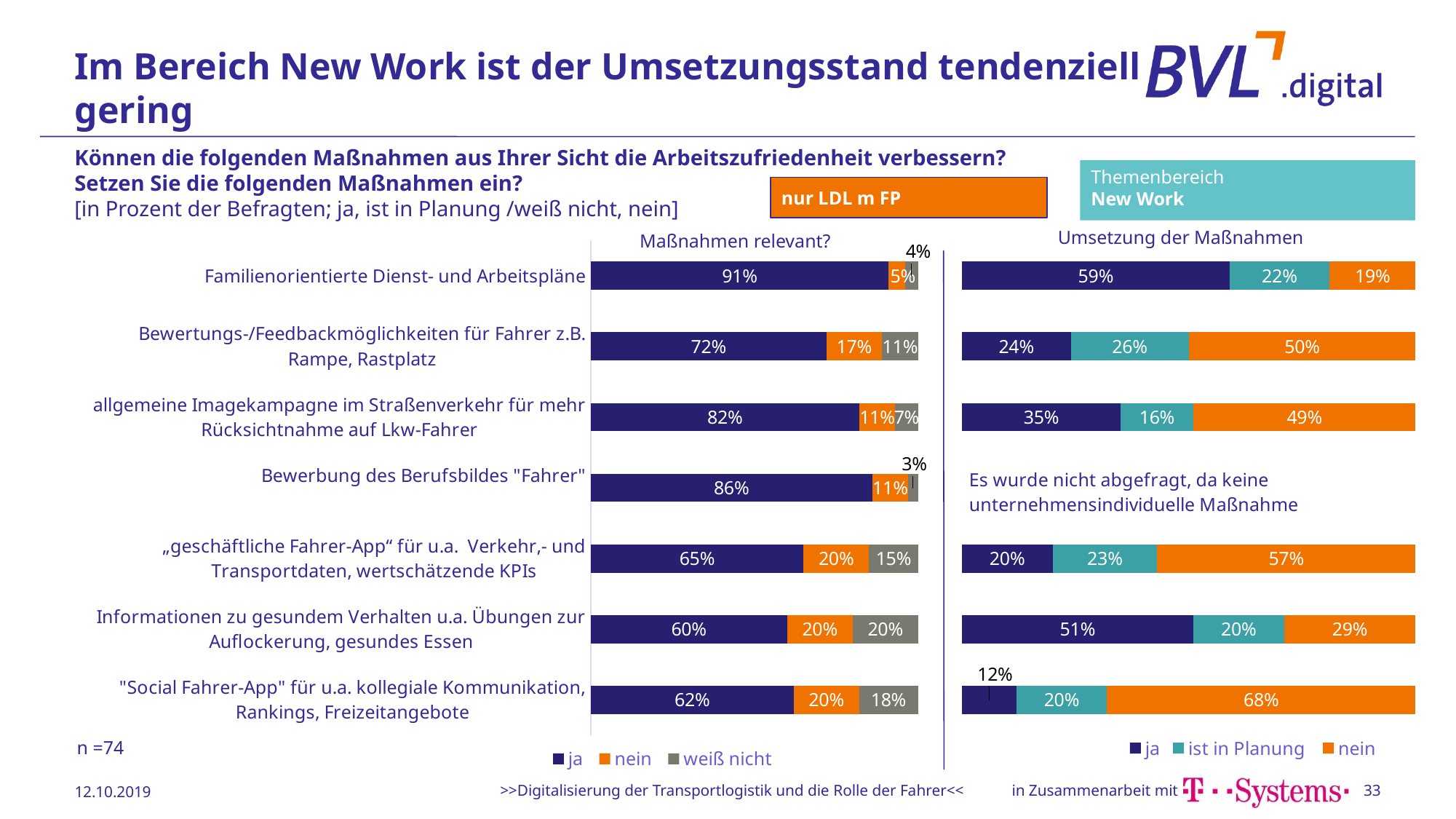
What kind of chart is the 'Maßnahmen relevant?' chart? Stacked bar chart In the 'Maßnahmen relevant?' chart, what is the difference between the 'ja' values for 'Bewerbung des Berufsbildes "Fahrer"' and 'Informationen zu gesundem Verhalten u.a. Übungen zur Auflockerung, gesundes Essen'? 26% In the 'Umsetzung der Maßnahmen' chart, what is the 'nein' value for '"Social Fahrer-App" für u.a. kollegiale Kommunikation, Rankings, Freizeitangebote'? 68% How many categories (bars) are shown in the 'Maßnahmen relevant?' chart? 7 In the 'Umsetzung der Maßnahmen' chart, which is larger: the 'ja' value for 'Familienorientierte Dienst- und Arbeitspläne' or the 'ja' value for 'allgemeine Imagekampagne im Straßenverkehr für mehr Rücksichtnahme auf Lkw-Fahrer'? Familienorientierte Dienst- und Arbeitspläne In the 'Umsetzung der Maßnahmen' chart, which category has the lowest 'ja' value? "Social Fahrer-App" für u.a. kollegiale Kommunikation, Rankings, Freizeitangebote In the 'Maßnahmen relevant?' chart, what is the 'ja' value for 'Familienorientierte Dienst- und Arbeitspläne'? 91% In the 'Umsetzung der Maßnahmen' chart, what is the total of the bar for '„geschäftliche Fahrer-App“ für u.a. Verkehr,- und Transportdaten, wertschätzende KPIs'? 100% In the 'Umsetzung der Maßnahmen' chart, what is the 'ist in Planung' value for 'Bewertungs-/Feedbackmöglichkeiten für Fahrer z.B. Rampe, Rastplatz'? 26% In the 'Maßnahmen relevant?' chart, which category has the highest 'ja' value? Familienorientierte Dienst- und Arbeitspläne How many bars are shown in the 'Umsetzung der Maßnahmen' chart? 6 How many series does the legend of the 'Umsetzung der Maßnahmen' chart list? 3